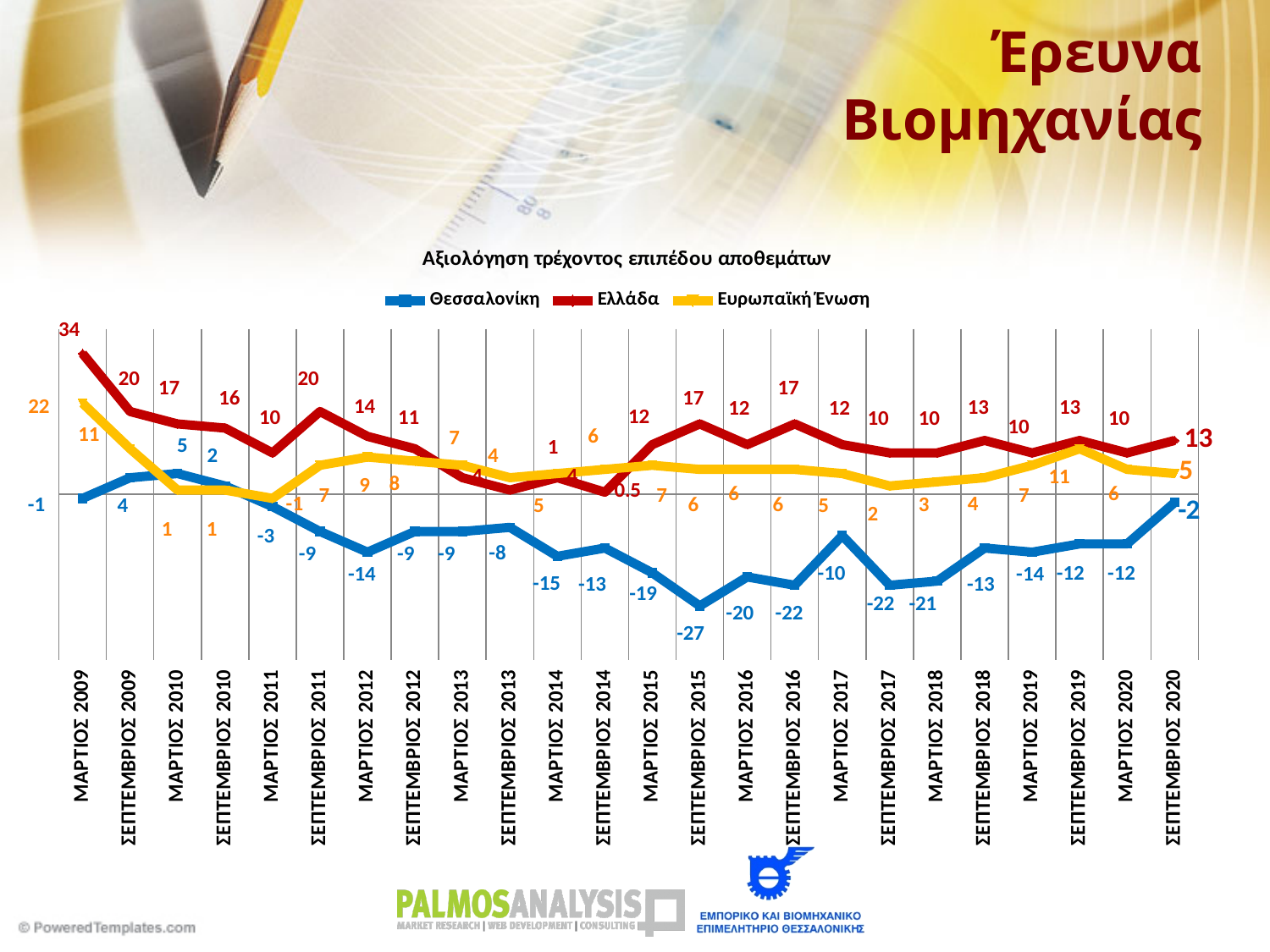
What is the title of the chart? Αξιολόγηση τρέχοντος επιπέδου αποθεμάτων What is the value for Ελλάδα in ΣΕΠΤΕΜΒΡΙΟΣ 2020? 13 What is the value for Ελλάδα in ΜΑΡΤΙΟΣ 2009? 34 What type of chart is shown on the slide? line chart In which period does Ελλάδα reach its highest value? ΜΑΡΤΙΟΣ 2009 In ΜΑΡΤΙΟΣ 2009, which is larger: the value for Ελλάδα or for Ευρωπαϊκή Ένωση? Ελλάδα What is the difference between the Ελλάδα and Θεσσαλονίκη values in ΣΕΠΤΕΜΒΡΙΟΣ 2020? 15 How many time periods are shown on the x axis? 24 What is the value for Θεσσαλονίκη in ΣΕΠΤΕΜΒΡΙΟΣ 2015? -27 What is the value for Θεσσαλονίκη in ΜΑΡΤΙΟΣ 2017? -10 How many series does the legend list? 3 In which period does Θεσσαλονίκη reach its lowest value? ΣΕΠΤΕΜΒΡΙΟΣ 2015